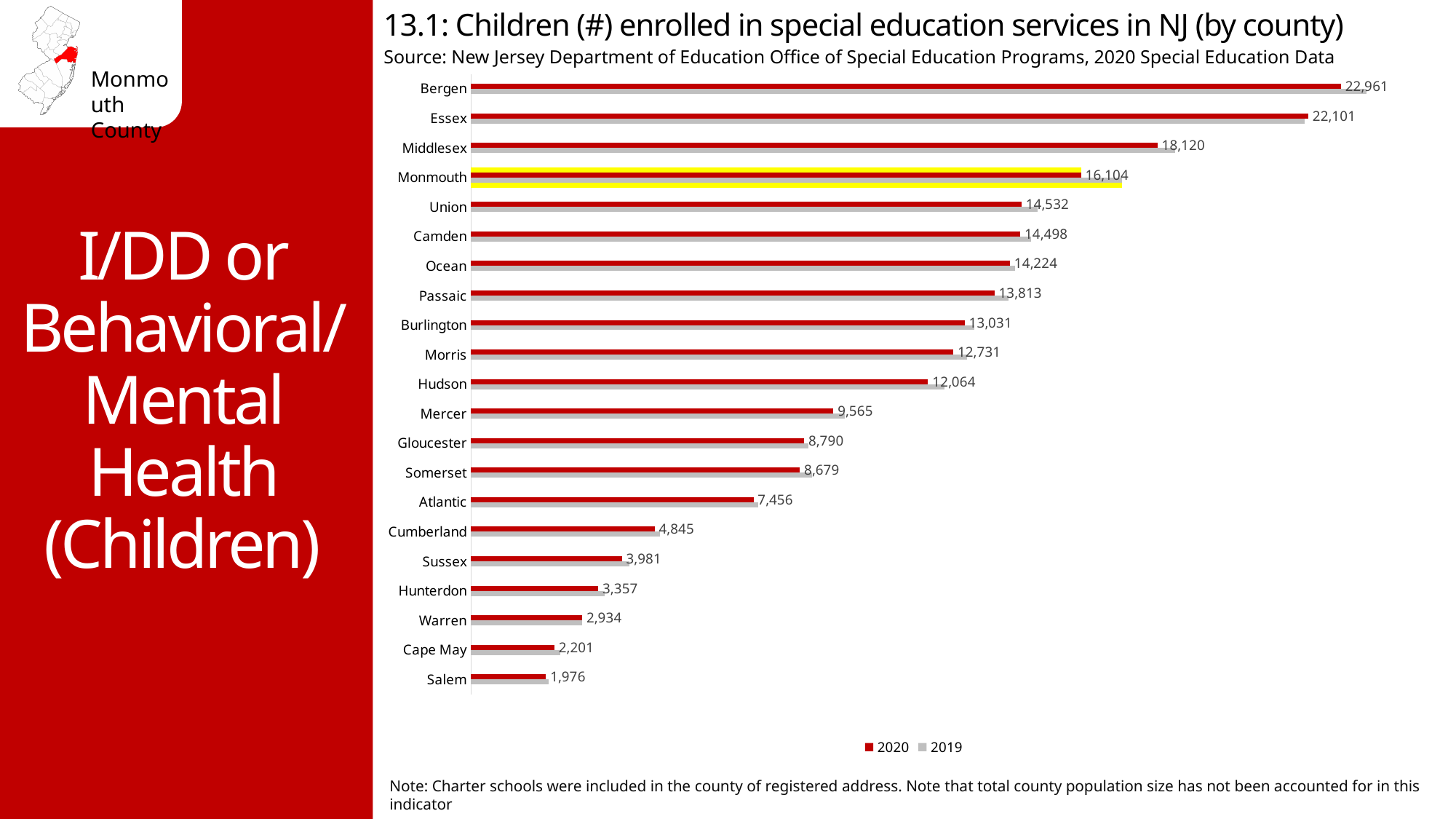
How many counties are shown on the chart? 21 What is the 2020 value for Monmouth? 16,104 How many series does the legend list? 2 What is the difference between the 2020 values for Monmouth and Union? 1,572 Which county has the lowest 2020 value? Salem What is the 2020 value for Bergen? 22,961 What is the 2020 value for Salem? 1,976 What is the difference between the 2020 values for Bergen and Essex? 860 Which has a larger 2020 value, Middlesex or Monmouth? Middlesex What kind of chart is this? Bar chart Which county has the highest 2020 value? Bergen Which county is highlighted in yellow on the chart? Monmouth